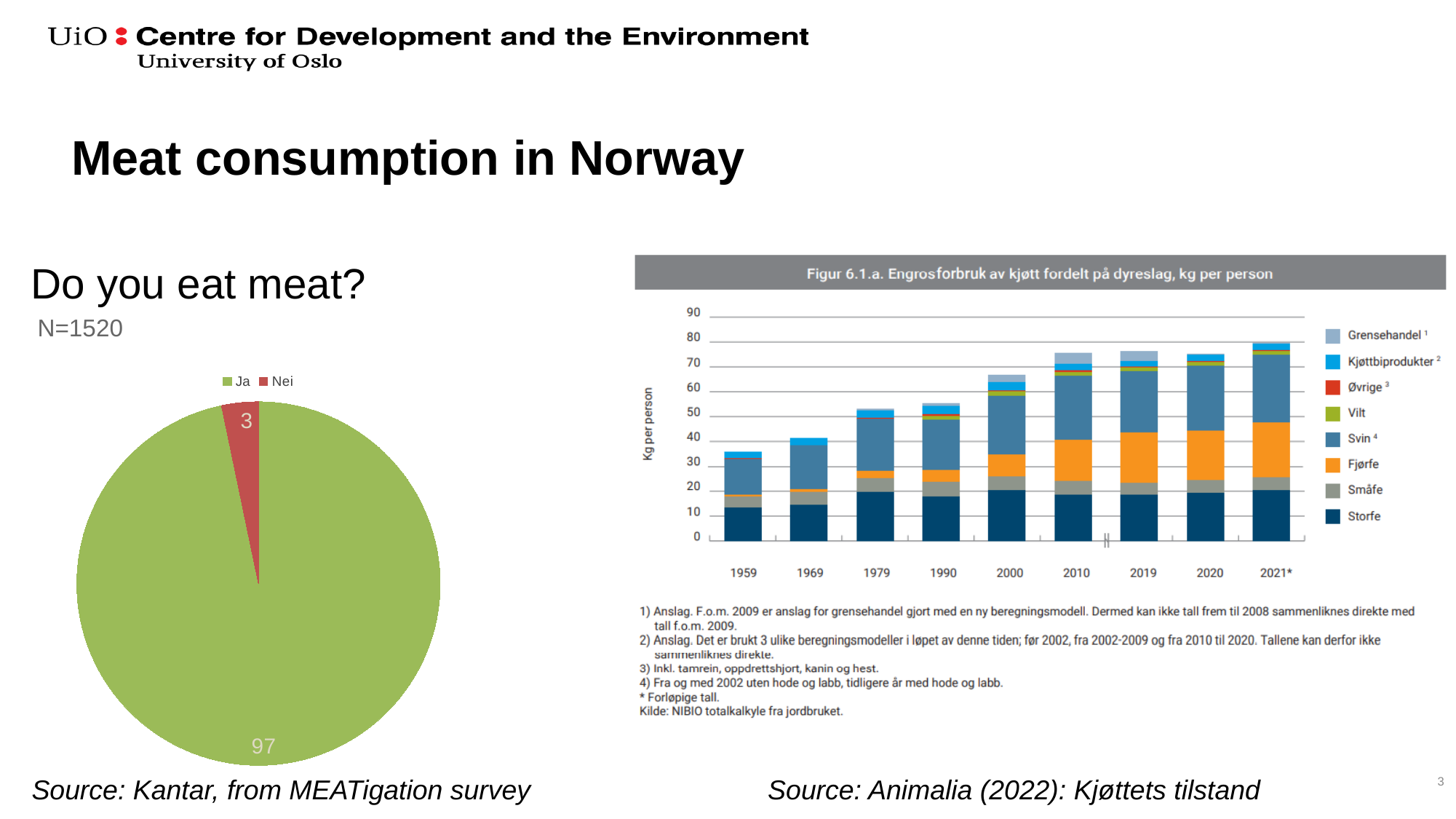
On the 'Do you eat meat?' pie chart, what value is shown for Nei? 3 On the 'Figur 6.1.a' chart, which year has the highest total bar? 2021* On the 'Figur 6.1.a' chart, how many series does the legend list? 8 On the 'Do you eat meat?' pie chart, what value is shown for Ja? 97 What kind of chart is the 'Do you eat meat?' chart on the left? Pie chart On the 'Do you eat meat?' pie chart, what is the difference between the Ja and Nei values? 94 On the 'Do you eat meat?' pie chart, what sample size (N) is stated? N=1520 On the 'Figur 6.1.a' chart, which year has the lowest total bar? 1959 On the 'Do you eat meat?' pie chart, which slice is larger, Ja or Nei? Ja On the 'Figur 6.1.a' chart, is the total for 1959 greater or less than 40 kg per person? less What kind of chart is 'Figur 6.1.a. Engrosforbruk av kjøtt fordelt på dyreslag, kg per person'? Stacked bar chart On the 'Figur 6.1.a' chart, how many years are shown on the x axis? 9